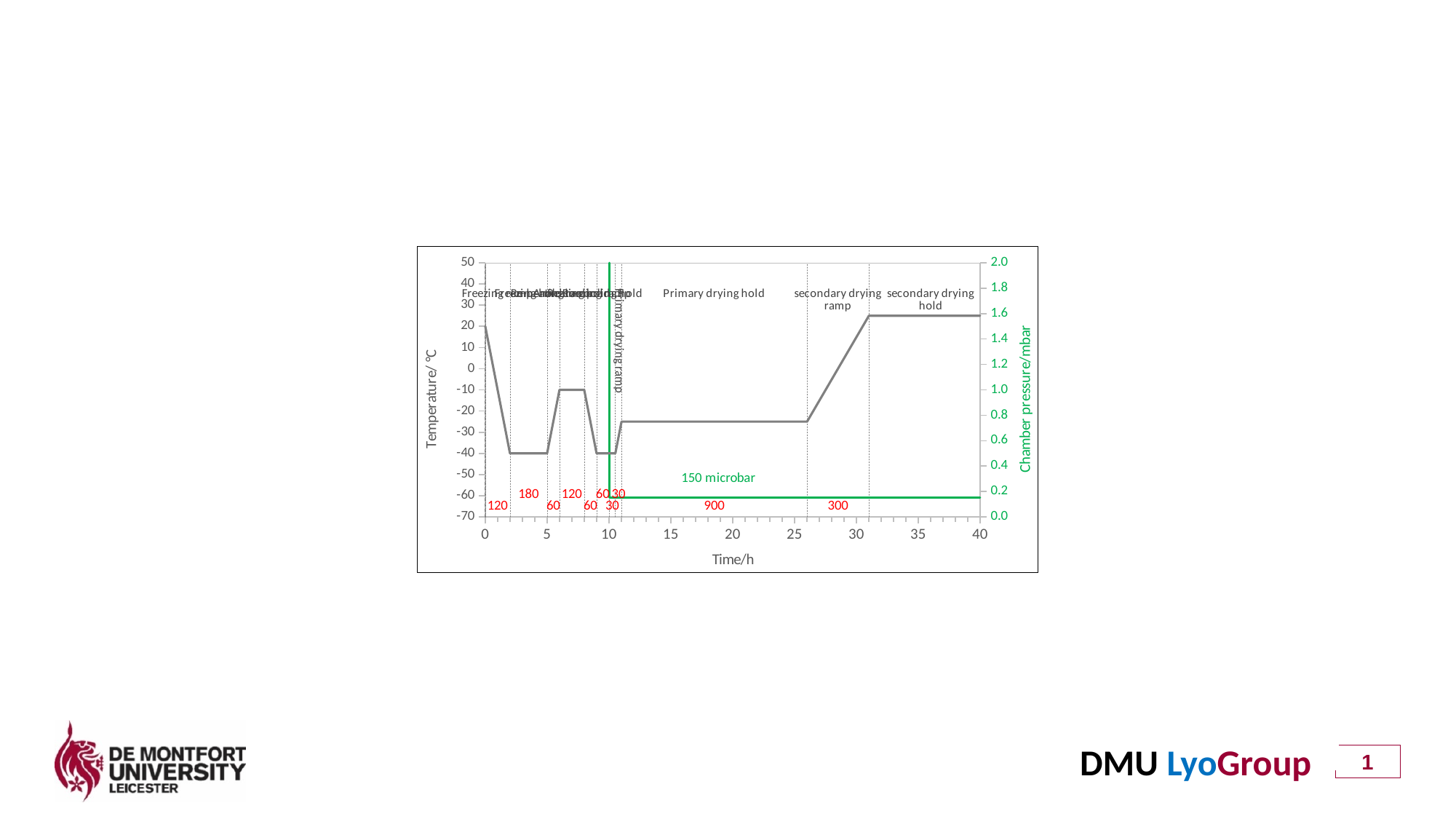
What red number is printed beneath the Primary drying hold phase? 900 Which is higher, the temperature at 35 h or the temperature at 20 h? 35 h Does the temperature rise or fall between 0 h and 2 h? fall What is the title of the right-hand (green) y axis of the chart? Chamber pressure/mbar Is the chamber pressure at 20 h greater or less than 0.4 mbar? less What is the title of the x axis of the chart? Time/h What red number is printed beneath the secondary drying ramp phase? 300 Is the temperature during the Primary drying hold (around 20 h) greater or less than 0 °C? less What chamber pressure value is labelled on the green line during primary drying? 150 microbar Does the temperature rise or fall between 26 h and 31 h (the secondary drying ramp)? rise What kind of chart is shown on the slide? line chart Is the temperature during the secondary drying hold (around 35 h) greater or less than 10 °C? greater